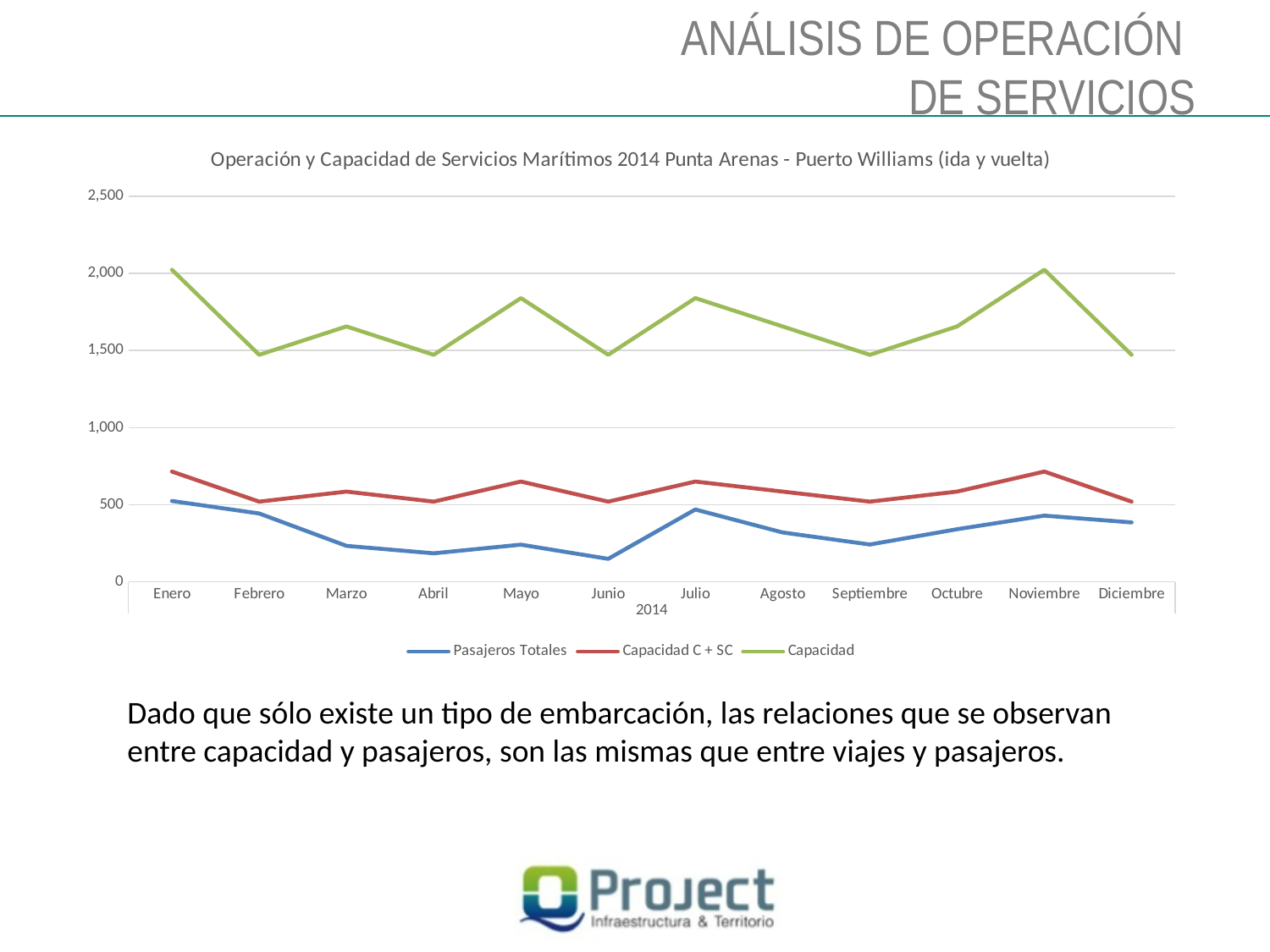
In which month is Pasajeros Totales highest? Enero Is the value of Capacidad for Mayo greater or less than 1,500? greater Which month has the higher Capacidad value, Mayo or Marzo? Mayo Is the value of Capacidad C + SC for Enero greater or less than 500? greater Does Pasajeros Totales rise or fall from Enero to Marzo? Fall What is the title of the chart? Operación y Capacidad de Servicios Marítimos 2014 Punta Arenas - Puerto Williams (ida y vuelta) What kind of chart is shown on the slide? Line chart How many months are plotted along the x axis of the chart? 12 Is the value of Pasajeros Totales for Junio greater or less than 500? less Which month has the higher Pasajeros Totales value, Julio or Junio? Julio Which series is drawn in green in the chart? Capacidad How many series does the chart legend list? 3